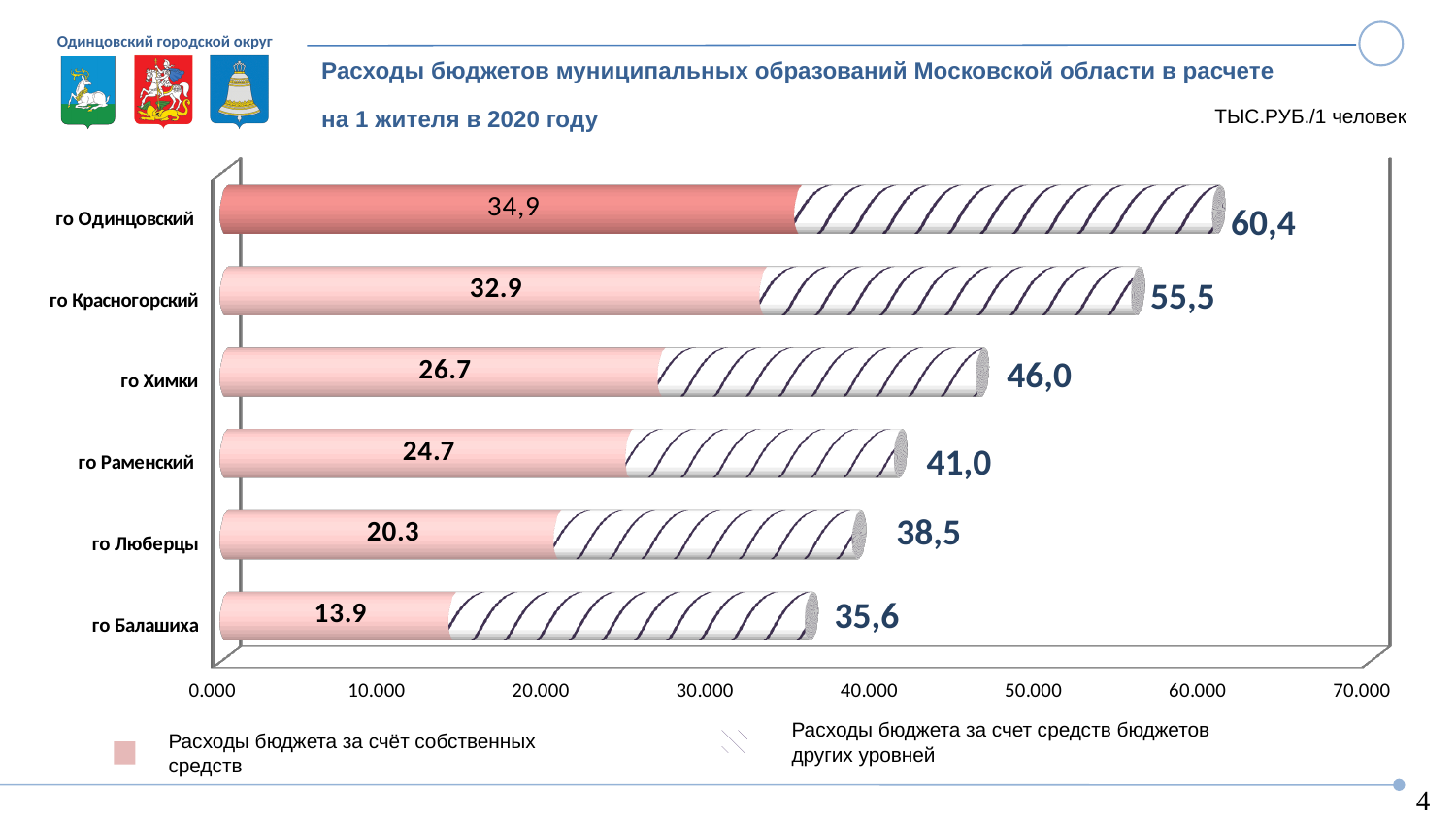
How many municipalities (categories) are shown in the chart? 6 What is the difference between the total values for го Красногорский and го Раменский? 14,5 Which municipality has the highest total expenditure per resident? го Одинцовский What is the value of expenditure from own funds (Расходы бюджета за счёт собственных средств) for го Химки? 26.7 Which has a larger own-funds expenditure value, го Красногорский or го Раменский? го Красногорский What is the total value shown for го Балашиха? 35,6 What is the own-funds expenditure value for го Люберцы? 20.3 What is the total budget expenditure per resident for го Одинцовский? 60,4 What unit is indicated for the values in the chart? ТЫС.РУБ./1 человек What kind of chart is shown on the slide? bar chart Which municipality has the lowest own-funds expenditure value? го Балашиха How many series does the legend list? 2